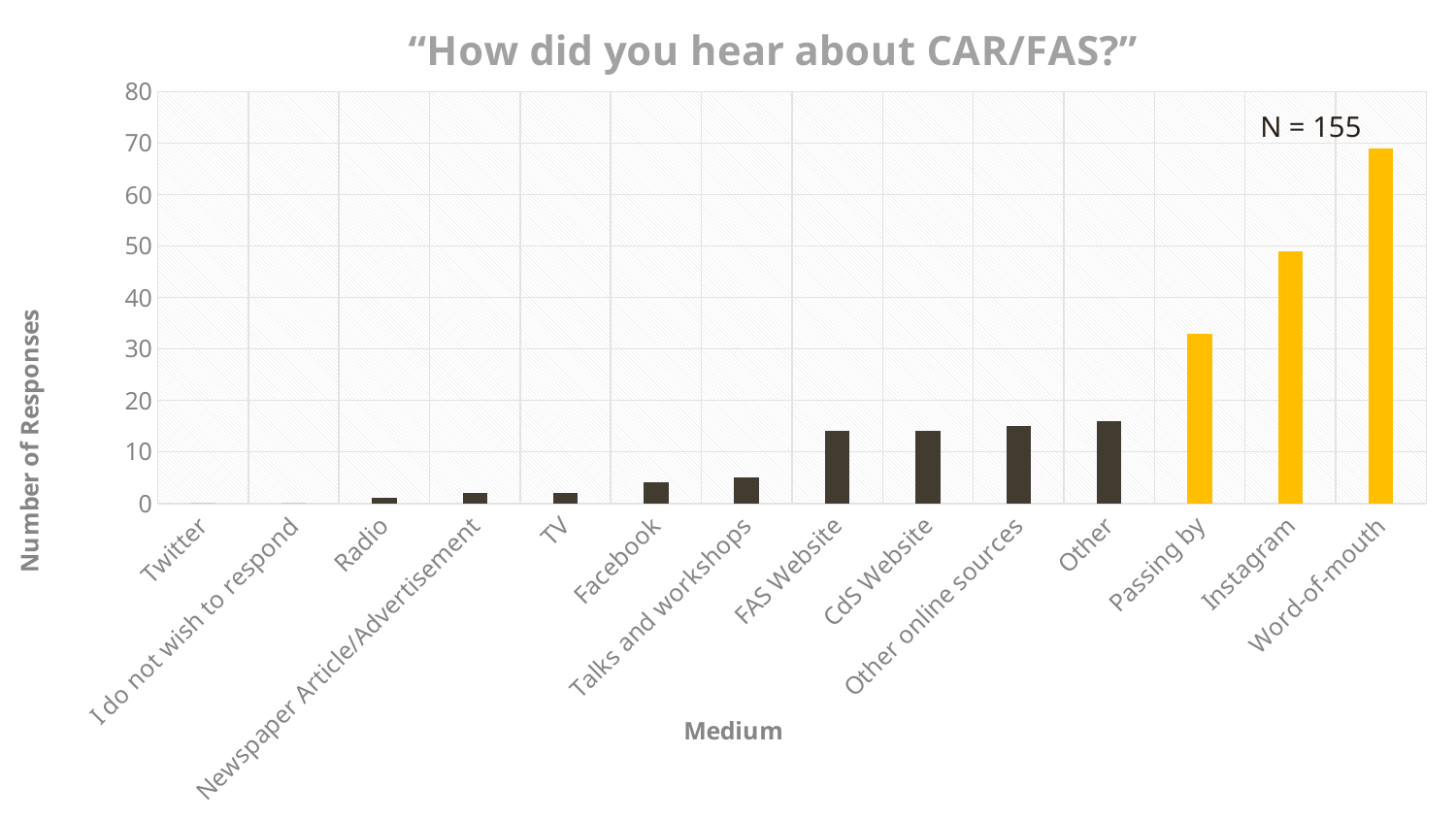
Is the number of responses for Word-of-mouth greater or less than 60? greater Which has more responses, Instagram or Passing by? Instagram Which medium has the highest number of responses? Word-of-mouth What kind of chart is shown on the slide? bar chart Which has more responses, Other online sources or Facebook? Other online sources Do the bar values generally rise or fall from left to right along the x axis? rise Is the number of responses for Other greater or less than 10? greater Is the number of responses for Instagram greater or less than 40? greater How many mediums (categories) are shown on the x axis? 14 What sample size is annotated on the chart? N = 155